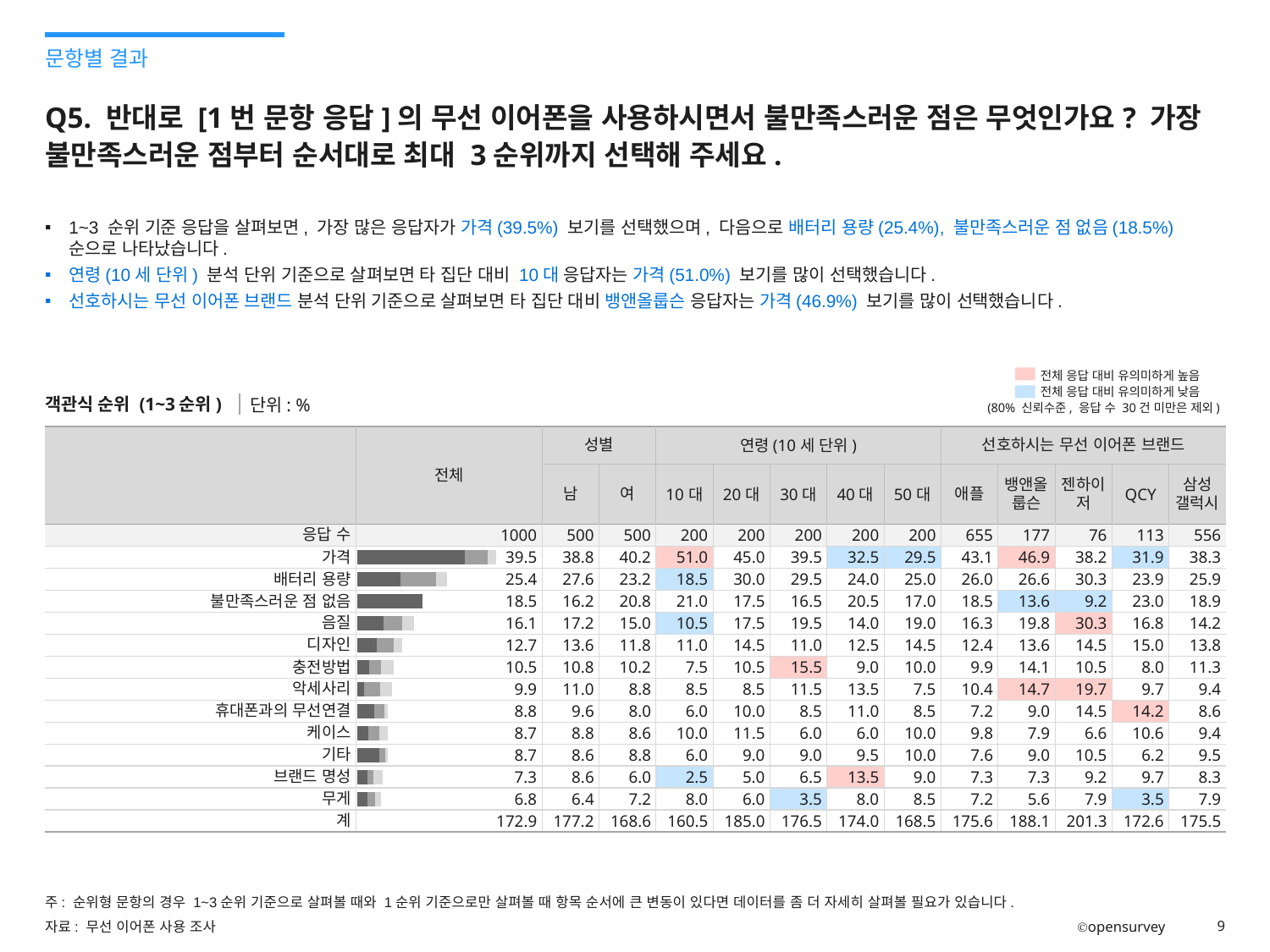
What is the 계 (total) of the 전체 column? 172.9 What kind of chart is embedded in the 전체 column of the table? bar chart What unit is stated for the values in the table? % Which has the larger 전체 value, 음질 or 디자인? 음질 What is the difference between the 전체 values for 가격 and 배터리 용량? 14.1 What is the 전체 value for 음질? 16.1 Which category has the highest 전체 value in the bar chart? 가격 How many categories (excluding 응답 수 and 계) are shown in the bar chart? 12 Do the 전체 bar values rise or fall going down the table from 가격 to 무게? fall What is the 전체 value for 배터리 용량? 25.4 Which category has the lowest 전체 value in the bar chart? 무게 What is the 전체 value for 가격? 39.5